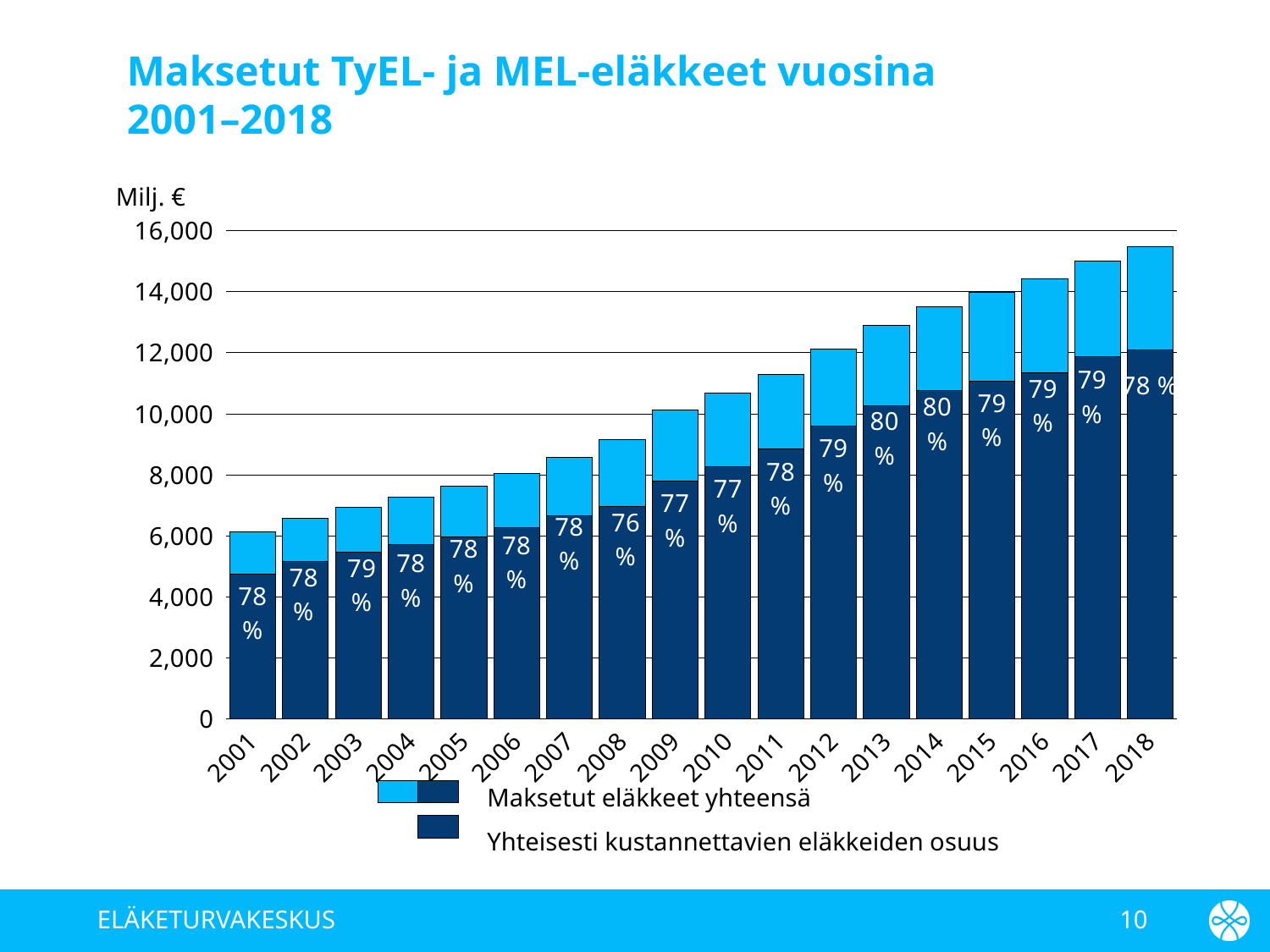
How many years are shown on the x axis? 18 What kind of chart is shown on the slide? Stacked bar chart Is the total bar height for 2001 greater or less than 8,000? less Do the total bar heights rise or fall from 2001 to 2018? Rise What percentage label is shown on the bar for 2008? 76 % How many series does the legend list? 2 Is the total bar height for 2018 greater or less than 14,000? greater Which years show the highest percentage label, 80 %? 2013 and 2014 What percentage label is shown on the bar for 2018? 78 % Which year has the lowest percentage label on its bar? 2008 What unit is shown above the y axis? Milj. € What percentage label is shown on the bar for 2013? 80 %